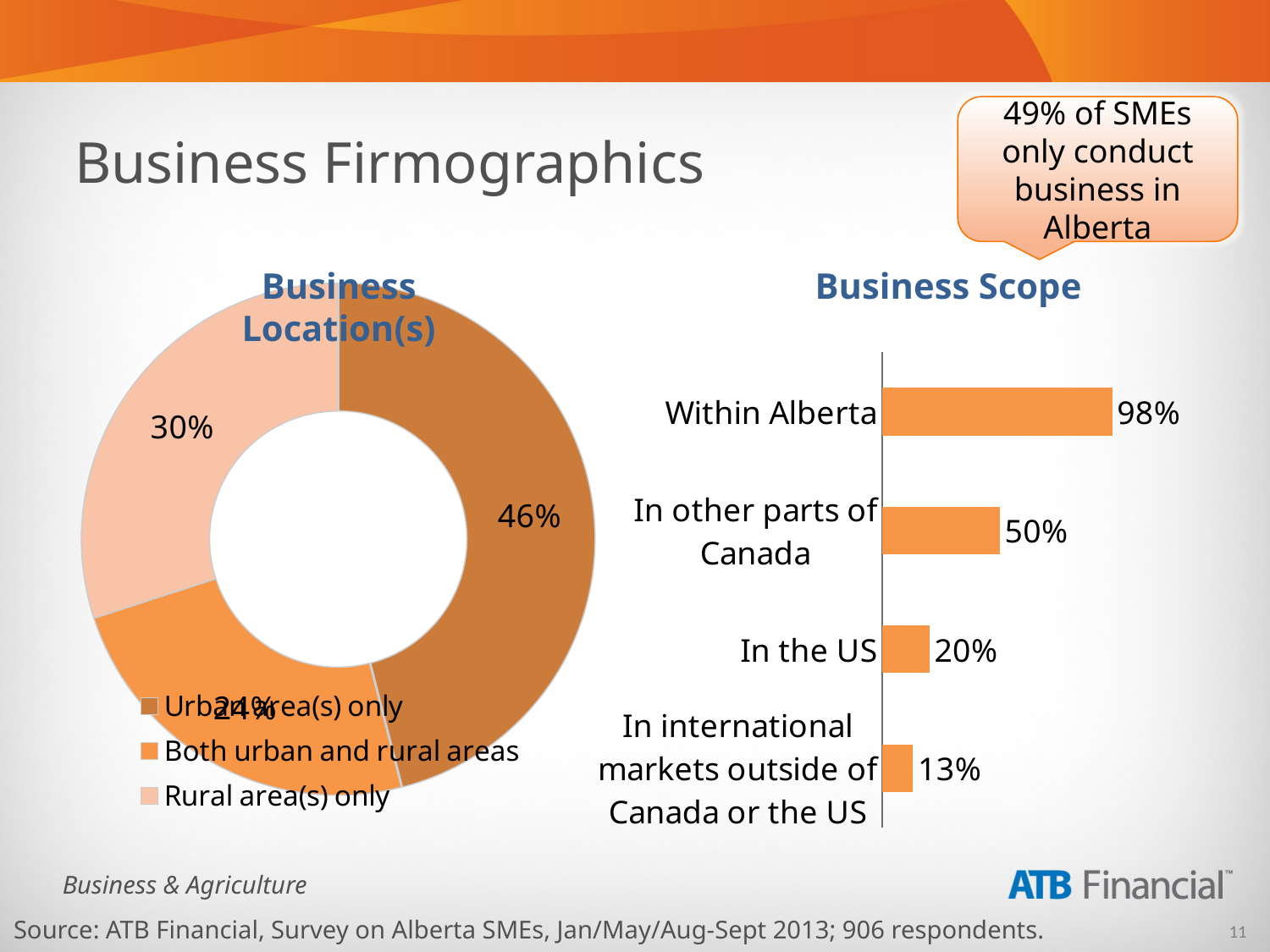
In the Business Scope chart, what is the value for In international markets outside of Canada or the US? 13% In the Business Location(s) chart, what share is Urban area(s) only? 46% In the Business Scope chart, which category has the highest value? Within Alberta In the Business Scope chart, which category has the lowest value? In international markets outside of Canada or the US What kind of chart is the Business Scope chart? Bar chart In the Business Location(s) chart, which is larger: Rural area(s) only or Both urban and rural areas? Rural area(s) only In the Business Scope chart, what is the value for Within Alberta? 98% In the Business Scope chart, what is the value for In other parts of Canada? 50% How many entries does the legend of the Business Location(s) chart list? 3 In the Business Location(s) chart, what share is Rural area(s) only? 30% In the Business Scope chart, how many categories are shown? 4 In the Business Scope chart, what is the difference between the values for Within Alberta and In the US? 78%